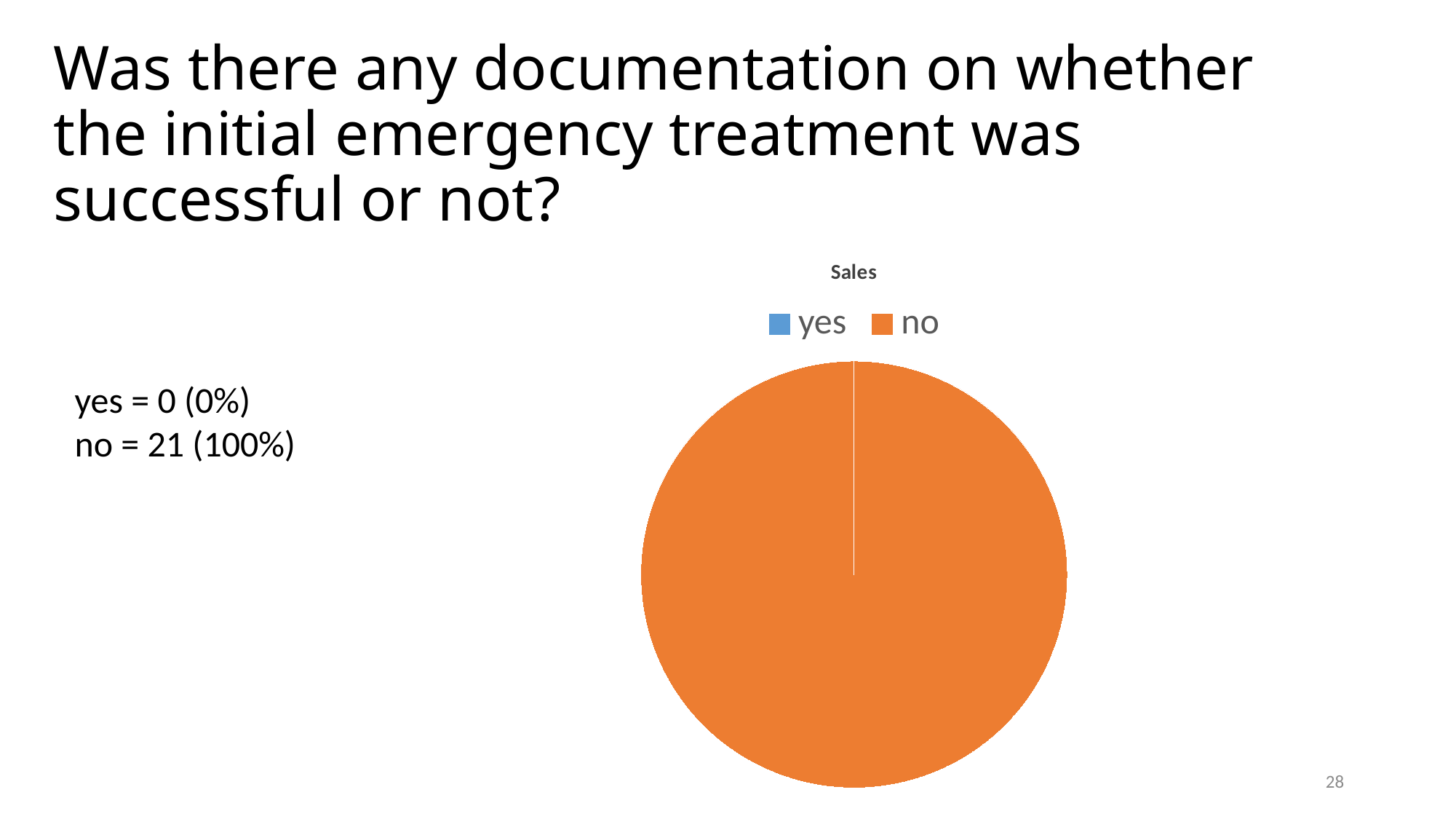
What is the count for the 'no' category? 21 What kind of chart is shown on the slide? pie chart What share of the pie does the 'yes' category take? 0% Which category fills the entire pie? no How many entries does the chart legend list? 2 What share of the pie does the 'no' category take? 100% Which category has the smallest share of the pie? yes Which is larger, the value for 'yes' or the value for 'no'? no What is the difference between the 'no' count and the 'yes' count? 21 What is the count for the 'yes' category? 0 What is the title of the chart? Sales What colour represents the 'no' category in the legend? orange